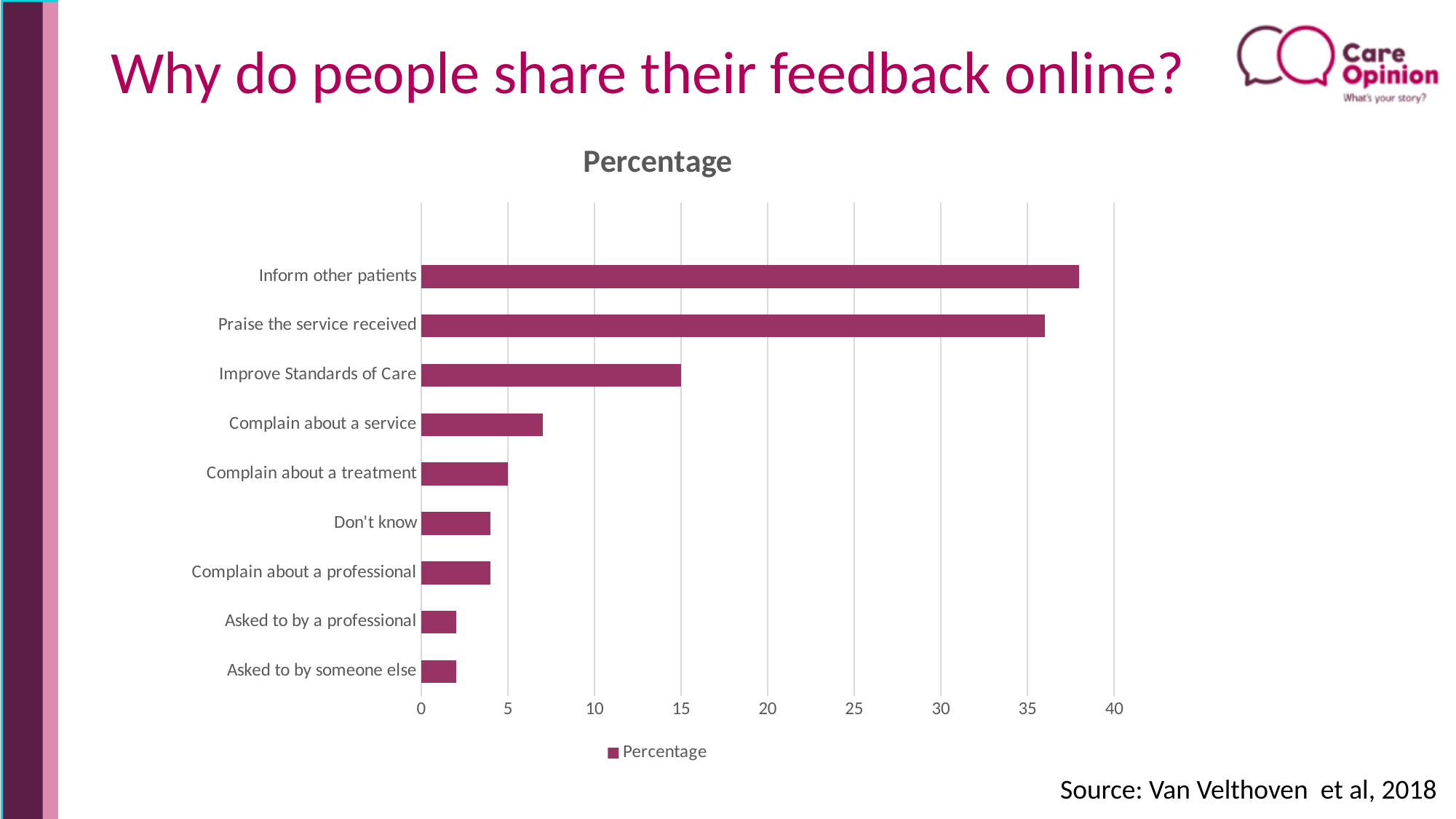
What is the value for Complain about a treatment? 5 Which category has the highest value? Inform other patients Is the value for Inform other patients greater or less than 35? greater Which is larger, the value for Improve Standards of Care or the value for Complain about a service? Improve Standards of Care Is the value for Asked to by a professional greater or less than 5? less What is the difference between the values for Improve Standards of Care and Complain about a treatment? 10 How many series does the legend list? 1 How many categories are plotted in the chart? 9 What is the value for Improve Standards of Care? 15 What type of chart is shown on the slide? Bar chart Is the value for Complain about a service greater or less than 10? less What is the title of the chart? Percentage